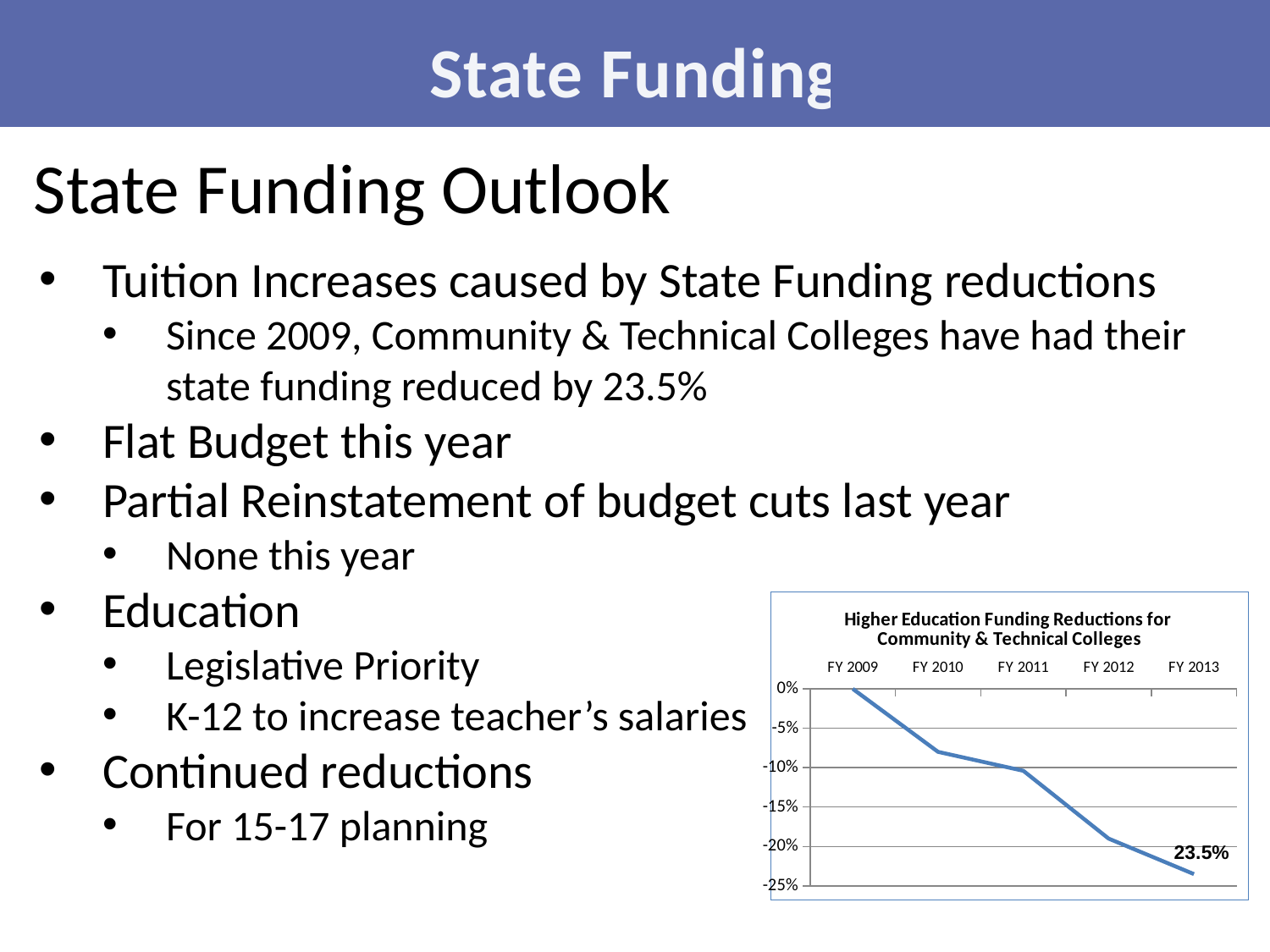
Which is larger, the value for FY 2010 or the value for FY 2012? FY 2010 How many fiscal years are plotted on the chart's x axis? 5 Which fiscal year has the lowest value on the chart? FY 2013 What value does the line start at for FY 2009? 0% Is the value for FY 2012 greater or less than -15%? less What is the data label shown at FY 2013 on the chart? 23.5% Which fiscal year has the highest value on the chart? FY 2009 Do the values on the chart rise or fall from FY 2009 to FY 2013? fall Is the value for FY 2010 greater or less than -5%? less What is the title of the chart on the slide? Higher Education Funding Reductions for Community & Technical Colleges What kind of chart is shown on the slide? line chart